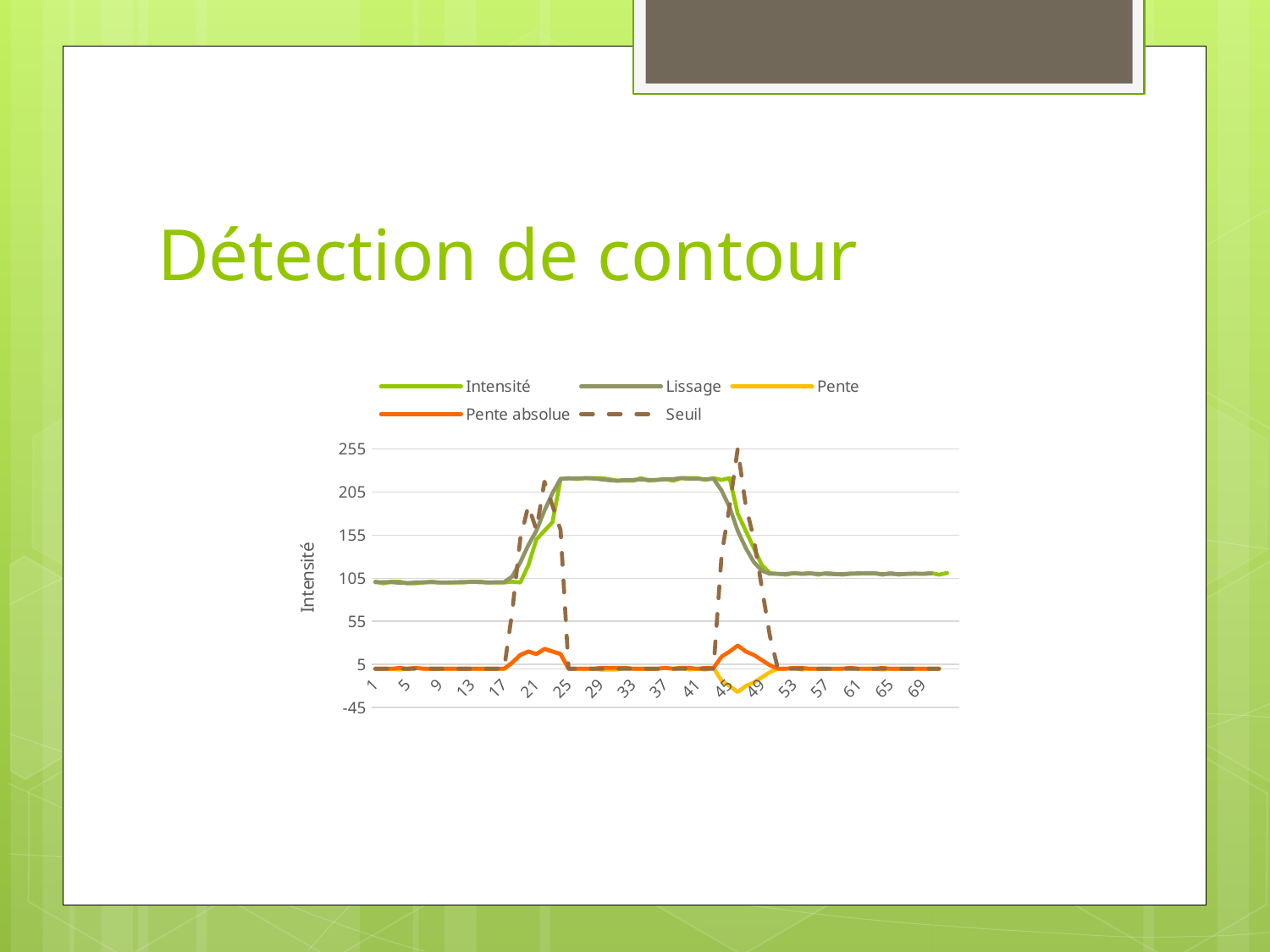
How many series does the chart legend list? 5 Is the value of the Intensité series at x = 33 greater or less than 205? greater What kind of chart is shown on the slide? line chart Which series in the legend is drawn with a dashed line? Seuil Does the Intensité series rise or fall between x = 17 and x = 25? rise Is the value of the Intensité series at x = 5 greater or less than 155? less Is the value of the Intensité series at x = 61 greater or less than 155? less Does the Lissage series rise or fall between x = 45 and x = 53? fall Which is larger for the Intensité series: the value at x = 33 or the value at x = 5? x = 33 What is the label of the vertical axis of the chart? Intensité